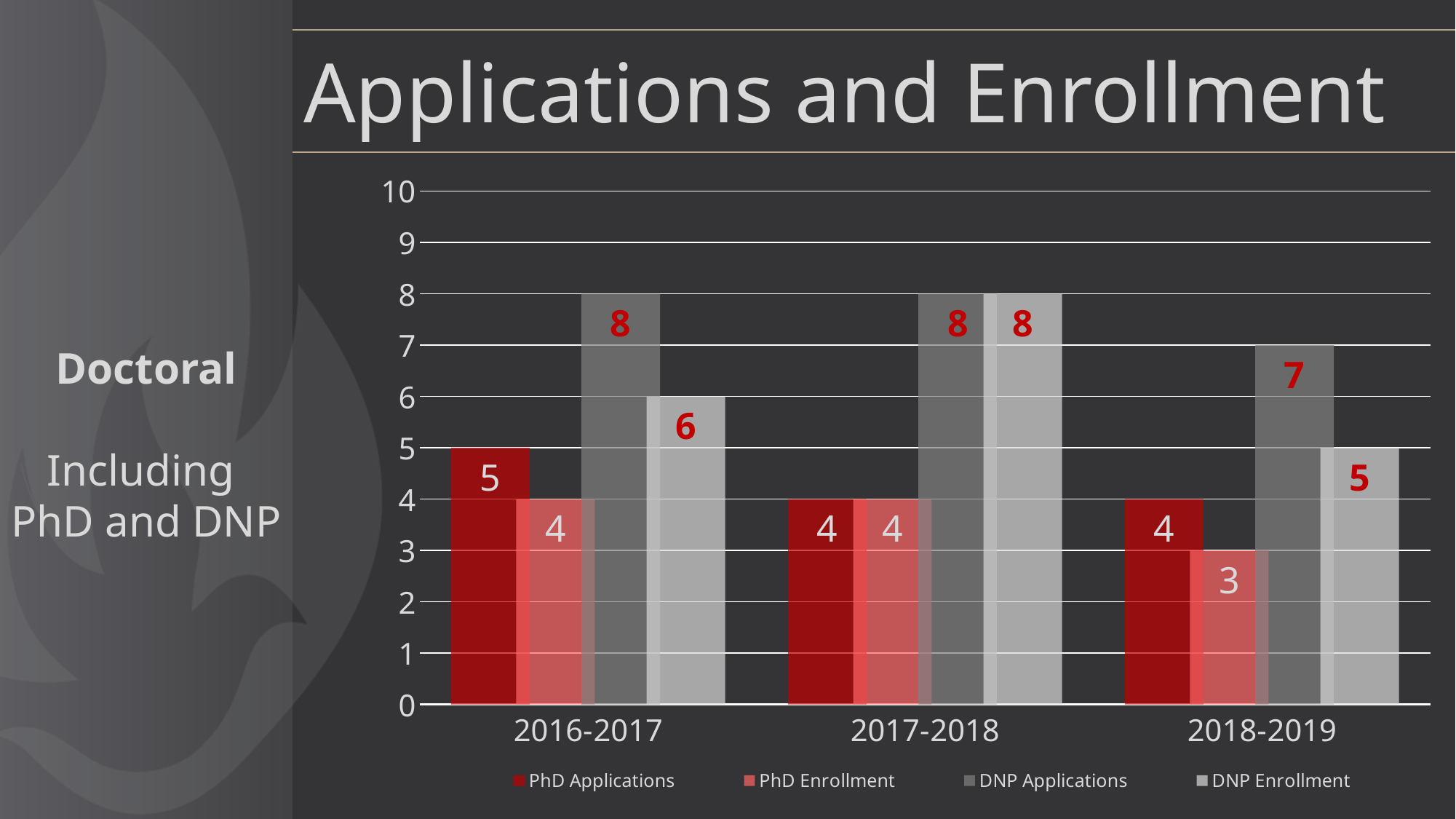
Which is larger in 2018-2019, DNP Applications or PhD Applications? DNP Applications What is the title of the chart on the slide? Applications and Enrollment Which year has the lowest PhD Enrollment? 2018-2019 What is the value for DNP Enrollment in 2018-2019? 5 How many series does the legend list? 4 What is the value for PhD Applications in 2016-2017? 5 What kind of chart is shown on the slide? Bar chart What is the difference between DNP Applications and DNP Enrollment in 2016-2017? 2 How many year categories are shown on the x axis? 3 What is the value for PhD Enrollment in 2018-2019? 3 Which year has the highest DNP Enrollment? 2017-2018 What is the value for DNP Applications in 2017-2018? 8